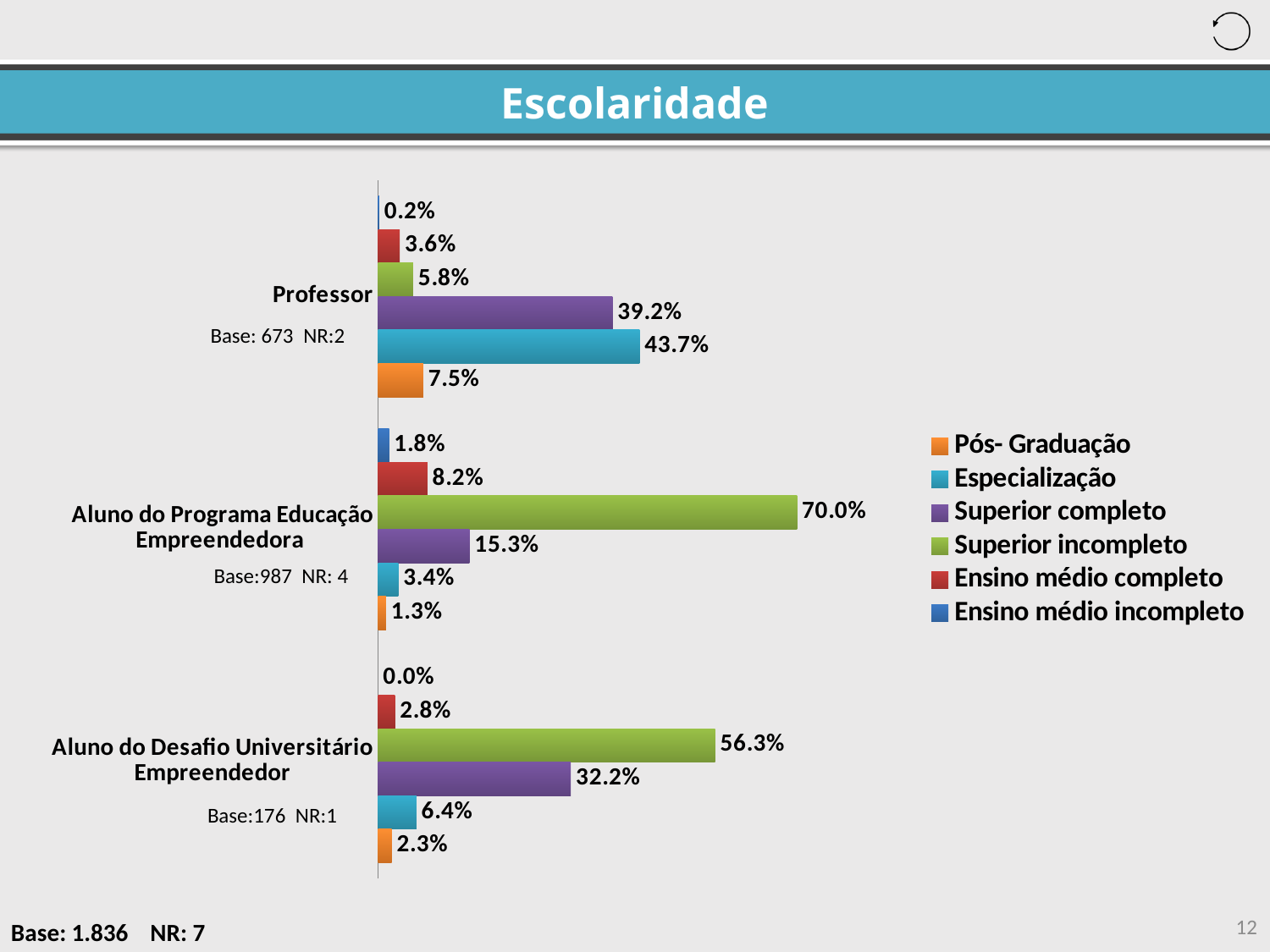
Which series has the highest value in the Professor group? Especialização What is the value for Especialização in the Professor group? 43.7% How many groups (categories) are shown on the chart? 3 Which series has the lowest value in the Aluno do Desafio Universitário Empreendedor group? Ensino médio incompleto What is the value for Superior completo in the Aluno do Desafio Universitário Empreendedor group? 32.2% What is the title of the slide? Escolaridade What is the value for Superior incompleto in the Aluno do Programa Educação Empreendedora group? 70.0% Which is larger in the Professor group: Superior completo or Especialização? Especialização How many series does the legend list? 6 What is the value for Pós- Graduação in the Professor group? 7.5% What kind of chart is shown on the slide? Bar chart What is the difference between Superior incompleto and Superior completo in the Aluno do Desafio Universitário Empreendedor group? 24.1%